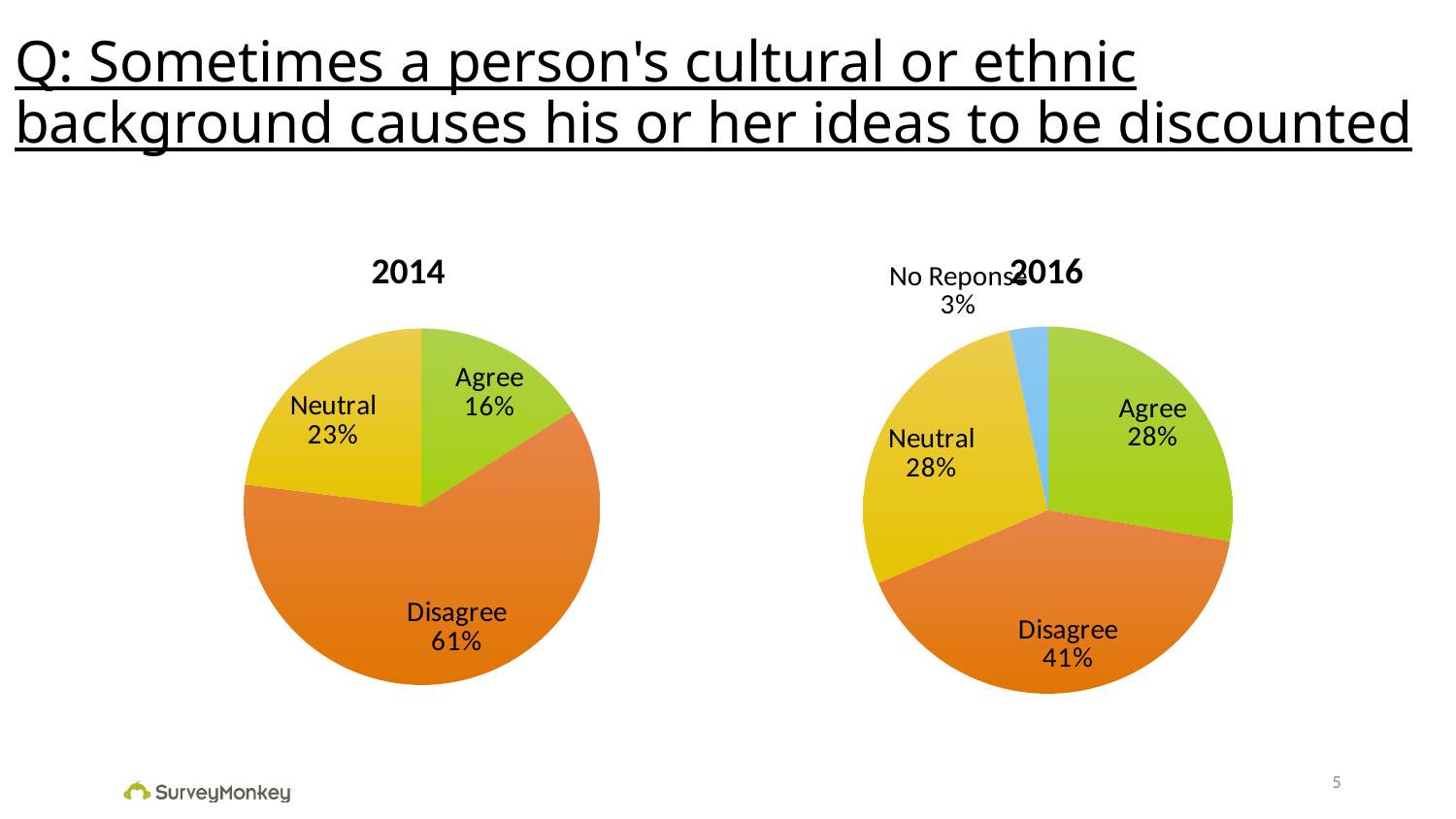
How many slices does the 2016 pie chart have? 4 In the 2014 pie chart, what is the difference between the Neutral and Agree shares? 7% In the 2016 pie chart, what percentage of respondents chose Neutral? 28% What is the difference between the Disagree share in 2014 and the Disagree share in 2016? 20% In the 2016 pie chart, what percentage is labelled No Reponse? 3% In the 2014 pie chart, what percentage of respondents chose Agree? 16% What type of chart is used for the 2014 data? Pie chart Which is larger: the Agree share in 2014 or the Agree share in 2016? 2016 In the 2014 pie chart, what percentage of respondents chose Disagree? 61% In the 2014 pie chart, which response has the largest share? Disagree How many slices does the 2014 pie chart have? 3 In the 2016 pie chart, which response has the smallest share? No Reponse